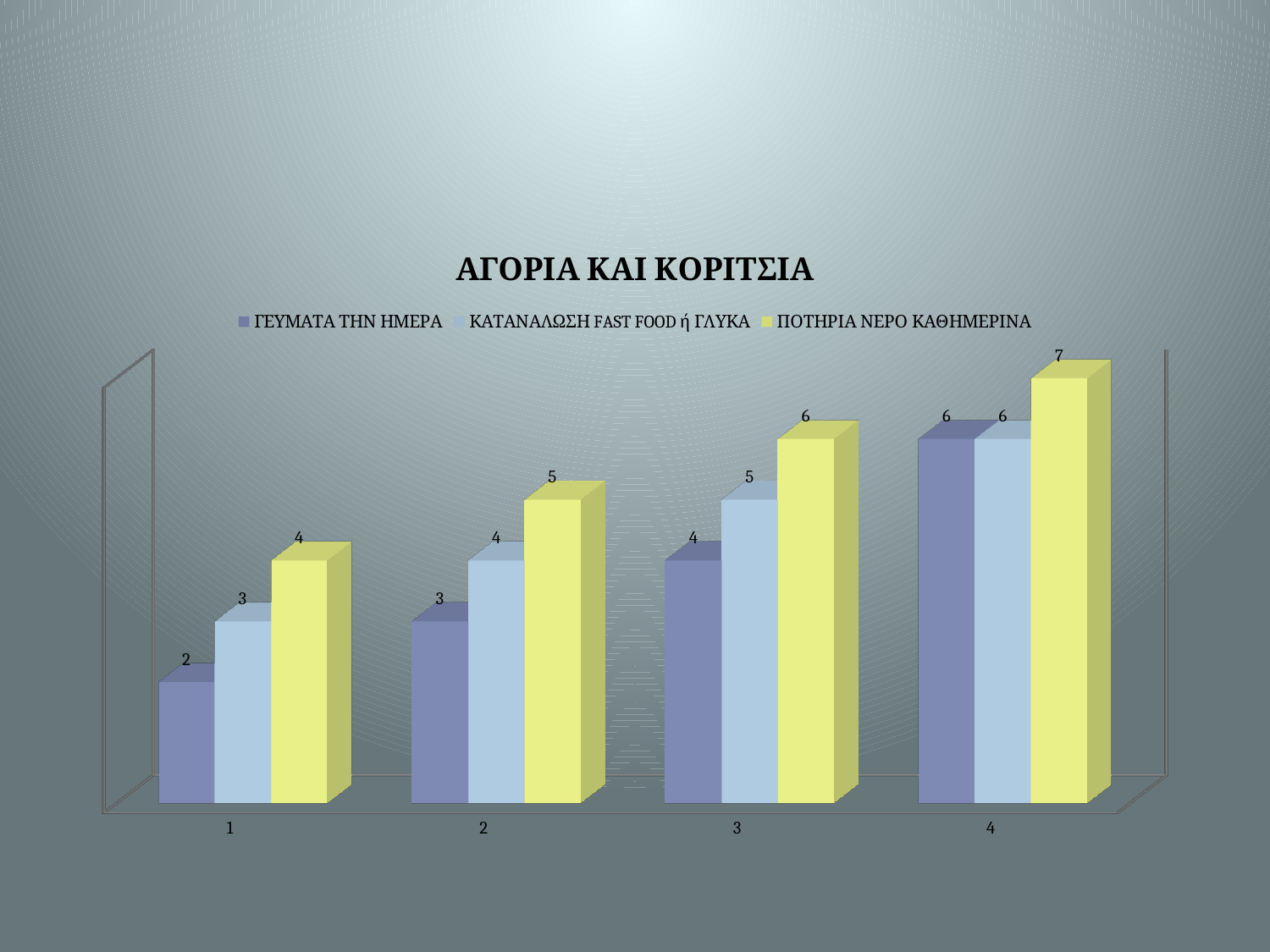
Do the values for ΚΑΤΑΝΑΛΩΣΗ FAST FOOD ή ΓΛΥΚΑ rise or fall from category 1 to category 4? rise What is the value of ΚΑΤΑΝΑΛΩΣΗ FAST FOOD ή ΓΛΥΚΑ for category 3? 5 Which category has the highest value for ΠΟΤΗΡΙΑ ΝΕΡΟ ΚΑΘΗΜΕΡΙΝΑ? 4 What kind of chart is shown on the slide? bar chart Which category has the lowest value for ΓΕΥΜΑΤΑ ΤΗΝ ΗΜΕΡΑ? 1 What is the difference between ΠΟΤΗΡΙΑ ΝΕΡΟ ΚΑΘΗΜΕΡΙΝΑ and ΓΕΥΜΑΤΑ ΤΗΝ ΗΜΕΡΑ for category 2? 2 What is the value of ΓΕΥΜΑΤΑ ΤΗΝ ΗΜΕΡΑ for category 1? 2 What is the title of the chart? ΑΓΟΡΙΑ ΚΑΙ ΚΟΡΙΤΣΙΑ How many categories are shown on the x axis? 4 How many series does the legend list? 3 For category 4, which is larger: ΓΕΥΜΑΤΑ ΤΗΝ ΗΜΕΡΑ or ΠΟΤΗΡΙΑ ΝΕΡΟ ΚΑΘΗΜΕΡΙΝΑ? ΠΟΤΗΡΙΑ ΝΕΡΟ ΚΑΘΗΜΕΡΙΝΑ What is the value of ΠΟΤΗΡΙΑ ΝΕΡΟ ΚΑΘΗΜΕΡΙΝΑ for category 4? 7